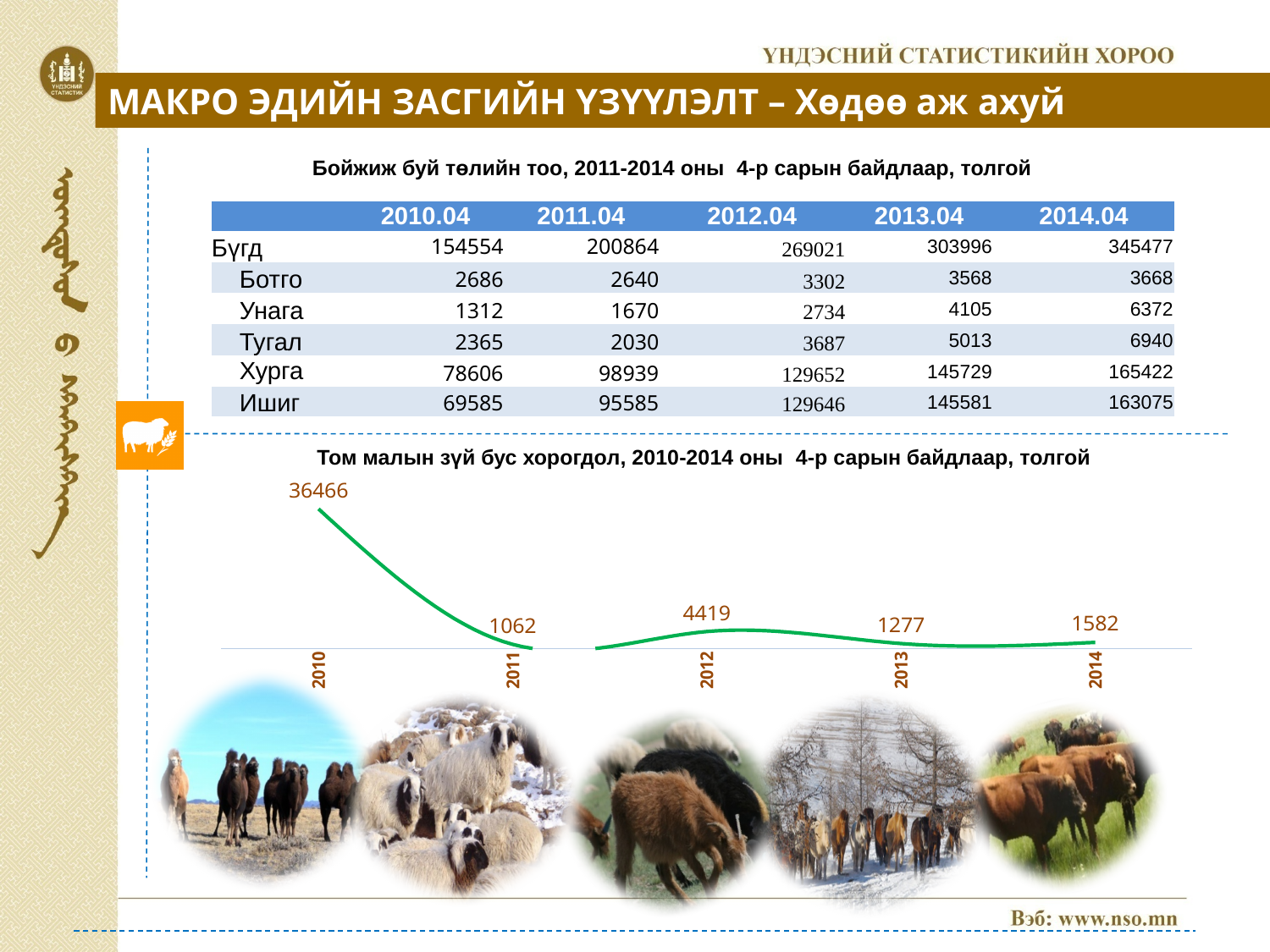
In the chart "Том малын зүй бус хорогдол", which year has the highest value? 2010 In the chart "Том малын зүй бус хорогдол", does the value rise or fall from 2010 to 2011? fall In the chart "Том малын зүй бус хорогдол", what is the value for 2014? 1582 In the chart "Том малын зүй бус хорогдол", what is the difference between the values for 2010 and 2011? 35404 What kind of chart is "Том малын зүй бус хорогдол, 2010-2014 оны 4-р сарын байдлаар, толгой"? line chart In the chart "Том малын зүй бус хорогдол", which year has the lowest value? 2011 In the chart "Том малын зүй бус хорогдол", what is the value for 2011? 1062 In the chart "Том малын зүй бус хорогдол", what is the difference between the values for 2014 and 2013? 305 In the chart "Том малын зүй бус хорогдол, 2010-2014 оны 4-р сарын байдлаар, толгой", what is the value for 2010? 36466 How many data points are plotted in the chart "Том малын зүй бус хорогдол"? 5 In the chart "Том малын зүй бус хорогдол", what is the value for 2012? 4419 In the chart "Том малын зүй бус хорогдол", which is larger, the value for 2012 or the value for 2013? 2012